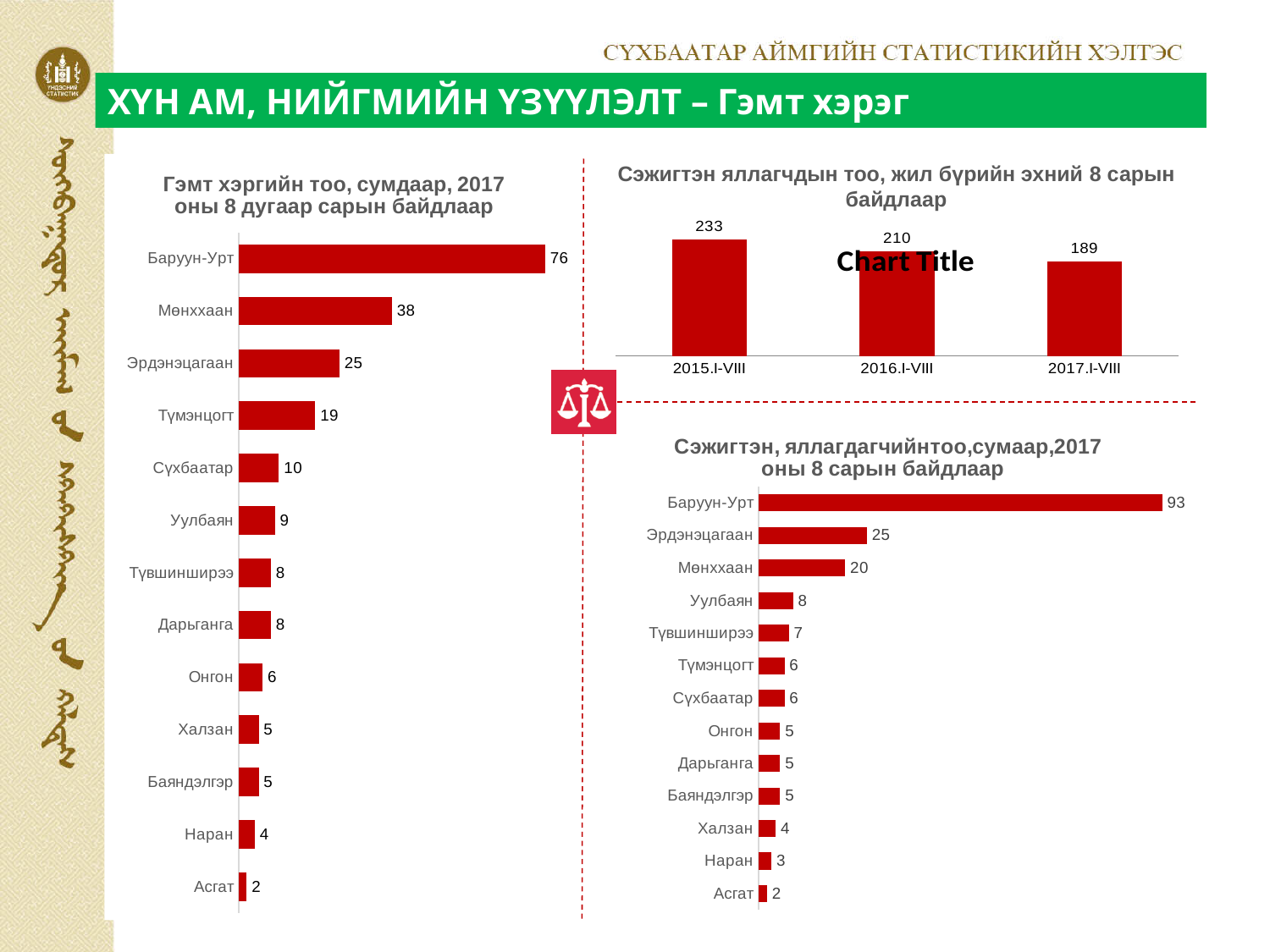
In the bottom-right chart 'Сэжигтэн, яллагдагчийн тоо, сумаар', which is larger, Эрдэнэцагаан or Мөнххаан? Эрдэнэцагаан In the left chart 'Гэмт хэргийн тоо, сумдаар', how many categories are shown? 13 In the bottom-right chart 'Сэжигтэн, яллагдагчийн тоо, сумаар', what is the value for Уулбаян? 8 In the bottom-right chart 'Сэжигтэн, яллагдагчийн тоо, сумаар, 2017 оны 8 сарын байдлаар', what is the value for Баруун-Урт? 93 In the left chart 'Гэмт хэргийн тоо, сумдаар', what is the value for Түмэнцогт? 19 What kind of chart is the top-right chart 'Сэжигтэн яллагчдын тоо'? bar chart In the top-right chart 'Сэжигтэн яллагчдын тоо', what is the difference between 2016.I-VIII and 2017.I-VIII? 21 In the top-right chart 'Сэжигтэн яллагчдын тоо', do the values rise or fall from 2015.I-VIII to 2017.I-VIII? fall In the left chart 'Гэмт хэргийн тоо, сумдаар, 2017 оны 8 дугаар сарын байдлаар', what is the value for Баруун-Урт? 76 In the left chart 'Гэмт хэргийн тоо, сумдаар', which category has the lowest value? Асгат In the top-right chart 'Сэжигтэн яллагчдын тоо, жил бүрийн эхний 8 сарын байдлаар', what is the value for 2015.I-VIII? 233 In the left chart 'Гэмт хэргийн тоо, сумдаар', what is the difference between Баруун-Урт and Мөнххаан? 38